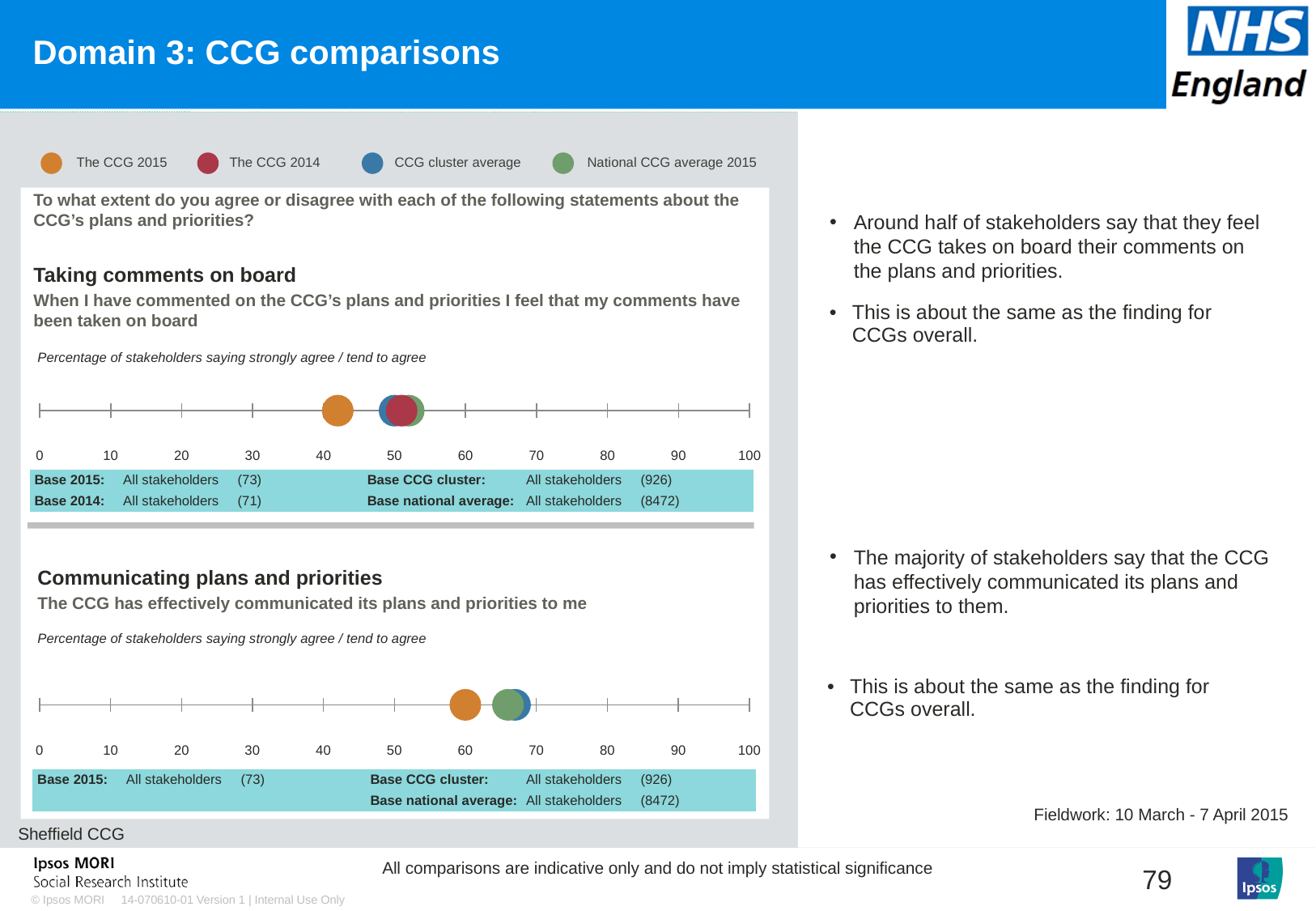
In the 'Taking comments on board' chart, is the value for CCG cluster average greater or less than 40? greater In the 'Taking comments on board' chart, which is larger: The CCG 2015 or The CCG 2014? The CCG 2014 In the 'Communicating plans and priorities' chart, is the value for National CCG average 2015 greater or less than 60? greater What kind of chart is used for 'Taking comments on board'? Dot plot In the 'Communicating plans and priorities' chart, which is larger: The CCG 2015 or National CCG average 2015? National CCG average 2015 What is the maximum value shown on the axis of the 'Taking comments on board' chart? 100 In the 'Taking comments on board' chart, is the value for The CCG 2015 greater or less than 50? less Which colour represents The CCG 2015 in the legend? Orange How many series does the legend at the top of the slide list? 4 How many markers are plotted in the 'Communicating plans and priorities' chart? 3